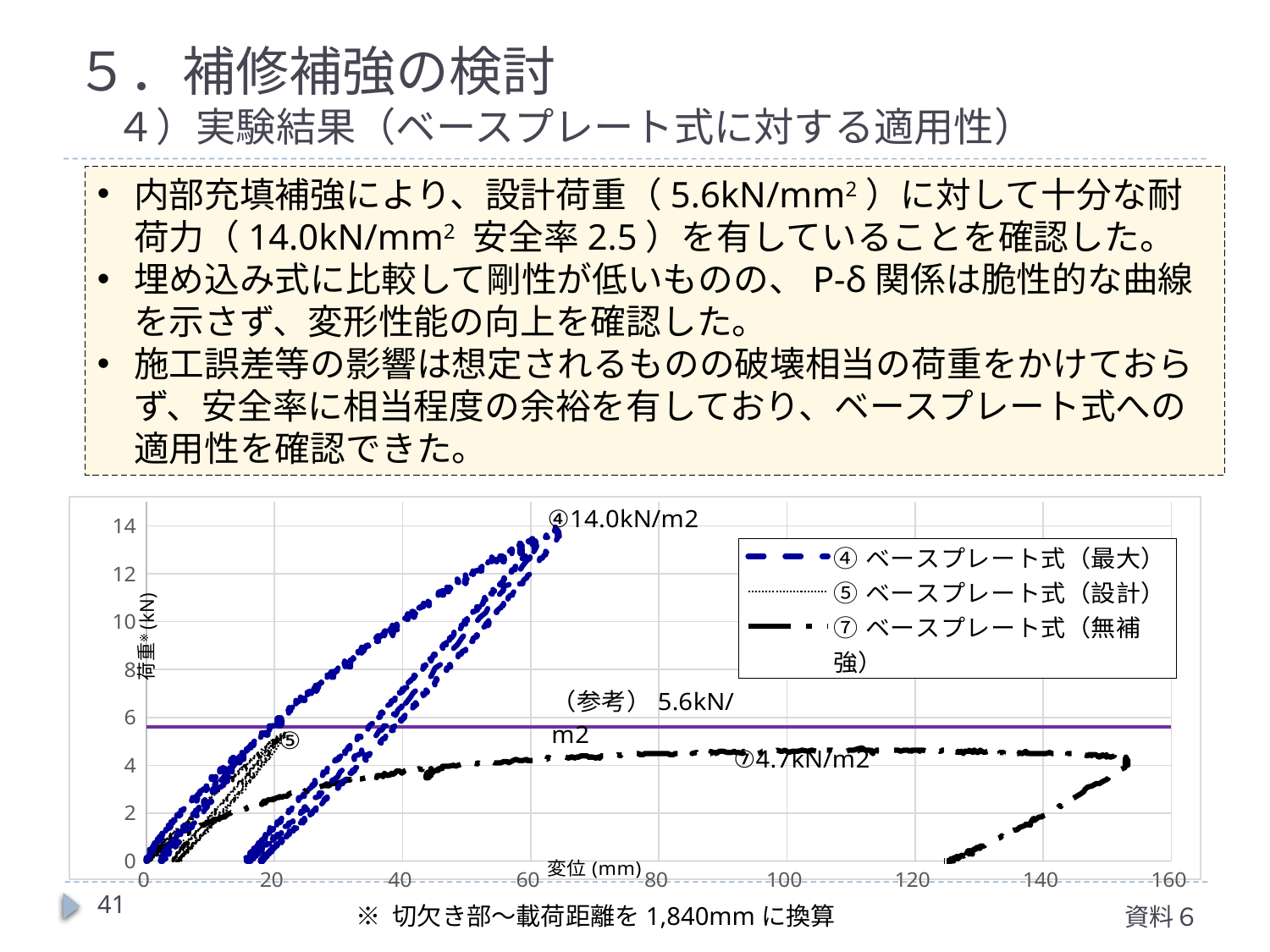
What is the difference between the labelled peak loads of series ④ and series ⑦? 9.3kN/m2 What is the label of the vertical axis? 荷重 (kN) Which series reaches the highest load in the chart? ④ ベースプレート式（最大） Which series has the lowest peak load in the chart? ⑦ ベースプレート式（無補強） What load value is marked by the horizontal reference line labelled （参考）? 5.6kN/m2 Is the maximum displacement reached by series ④ greater or less than 80 mm? less How many series does the chart legend list? 3 Is the maximum displacement reached by series ⑦ greater or less than 140 mm? greater What is the labelled maximum load for series ⑦ ベースプレート式（無補強）? 4.7kN/m2 What is the labelled maximum load for series ④ ベースプレート式（最大）? 14.0kN/m2 What type of chart is shown on the slide? line chart Which has a larger labelled peak load, series ④ or series ⑦? ④